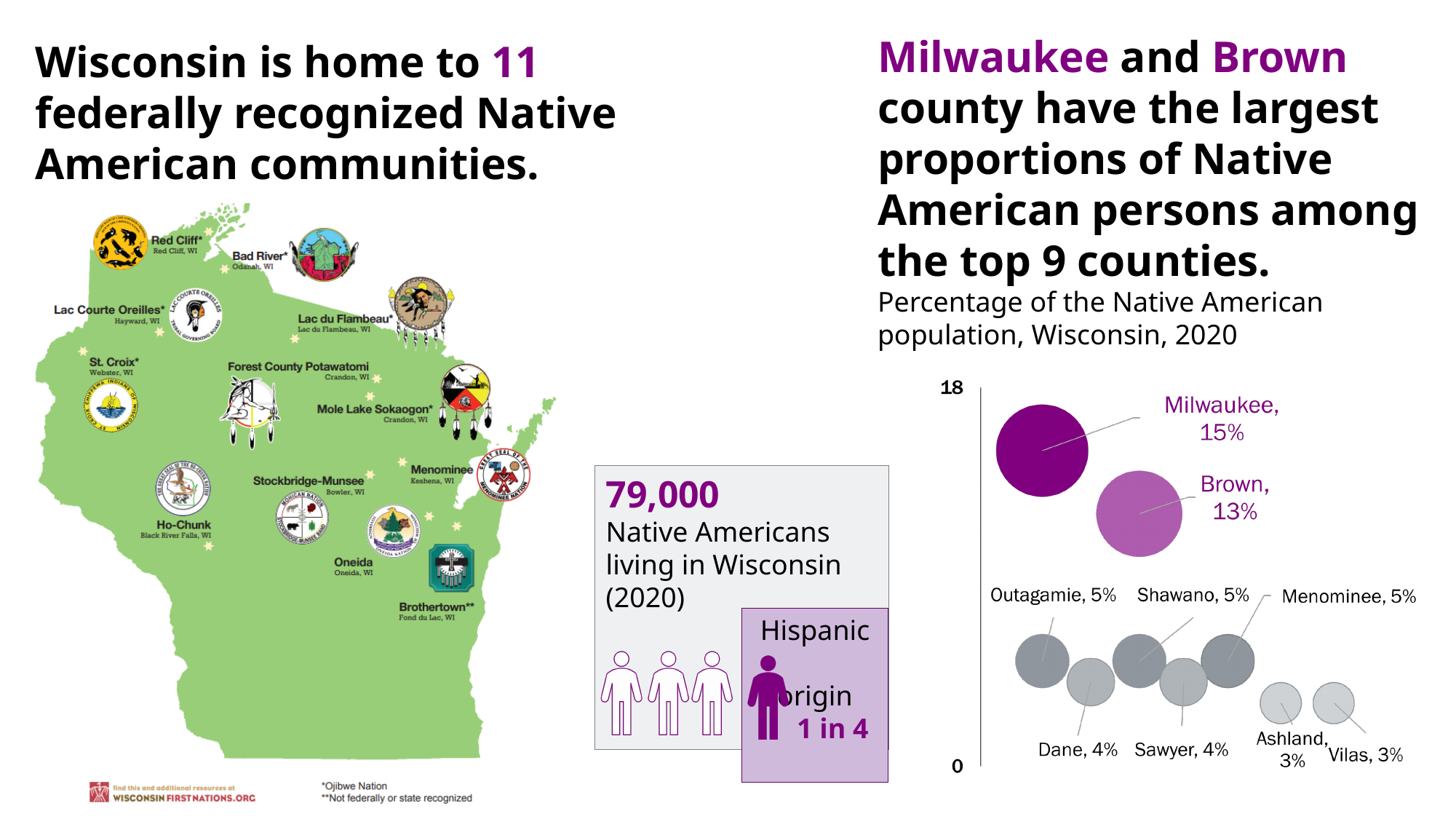
What is the difference in percentage points between Outagamie and Ashland county? 2 Which has a larger percentage, Brown county or Shawano county? Brown What percentage of the Native American population is in Dane county? 4% What percentage of the Native American population is in Milwaukee county? 15% Which county has the highest percentage of the Native American population in the chart? Milwaukee What percentage of the Native American population is in Brown county? 13% Which has a larger percentage, Sawyer county or Milwaukee county? Milwaukee How many counties are shown in the chart? 9 What percentage of the Native American population is in Vilas county? 3% What is the difference in percentage points between Milwaukee and Brown county? 2 What is the maximum value shown on the chart's vertical axis? 18 What year does the chart's data refer to? 2020